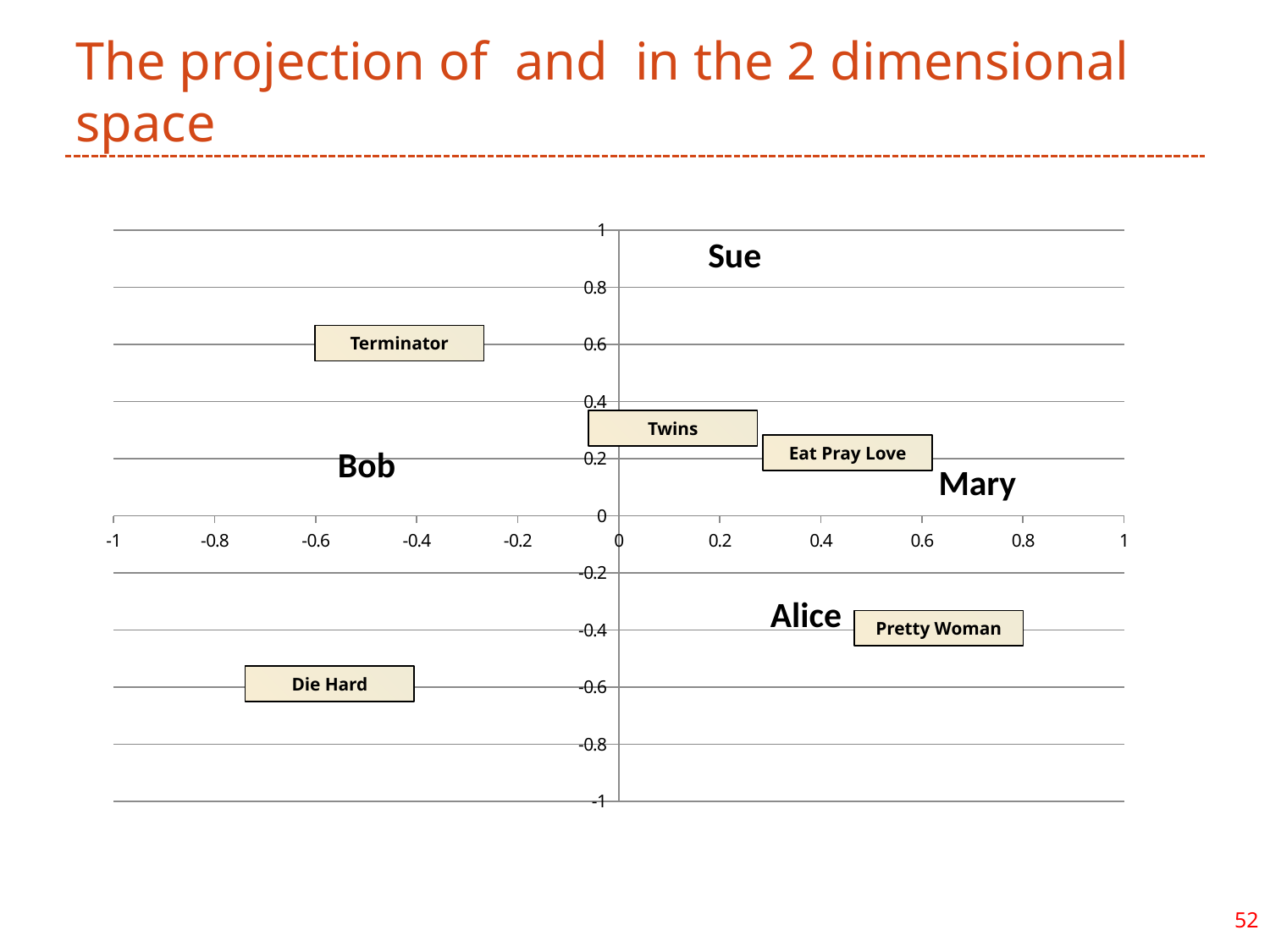
How many movie titles are plotted as labelled boxes on the chart? 5 How many user names (Sue, Bob, Mary, Alice) are shown on the chart? 4 Is the horizontal-axis value for Pretty Woman greater or less than 0.4? greater Is the vertical-axis value for Die Hard greater or less than -0.4? less Is the vertical-axis value for Terminator greater or less than 0? greater Which movie is plotted highest on the vertical axis? Terminator Which is plotted further to the right on the horizontal axis, Pretty Woman or Die Hard? Pretty Woman What are the minimum and maximum values shown on the horizontal axis? -1 and 1 Which movie is plotted lowest on the vertical axis? Die Hard What kind of chart is shown on the slide? scatter chart